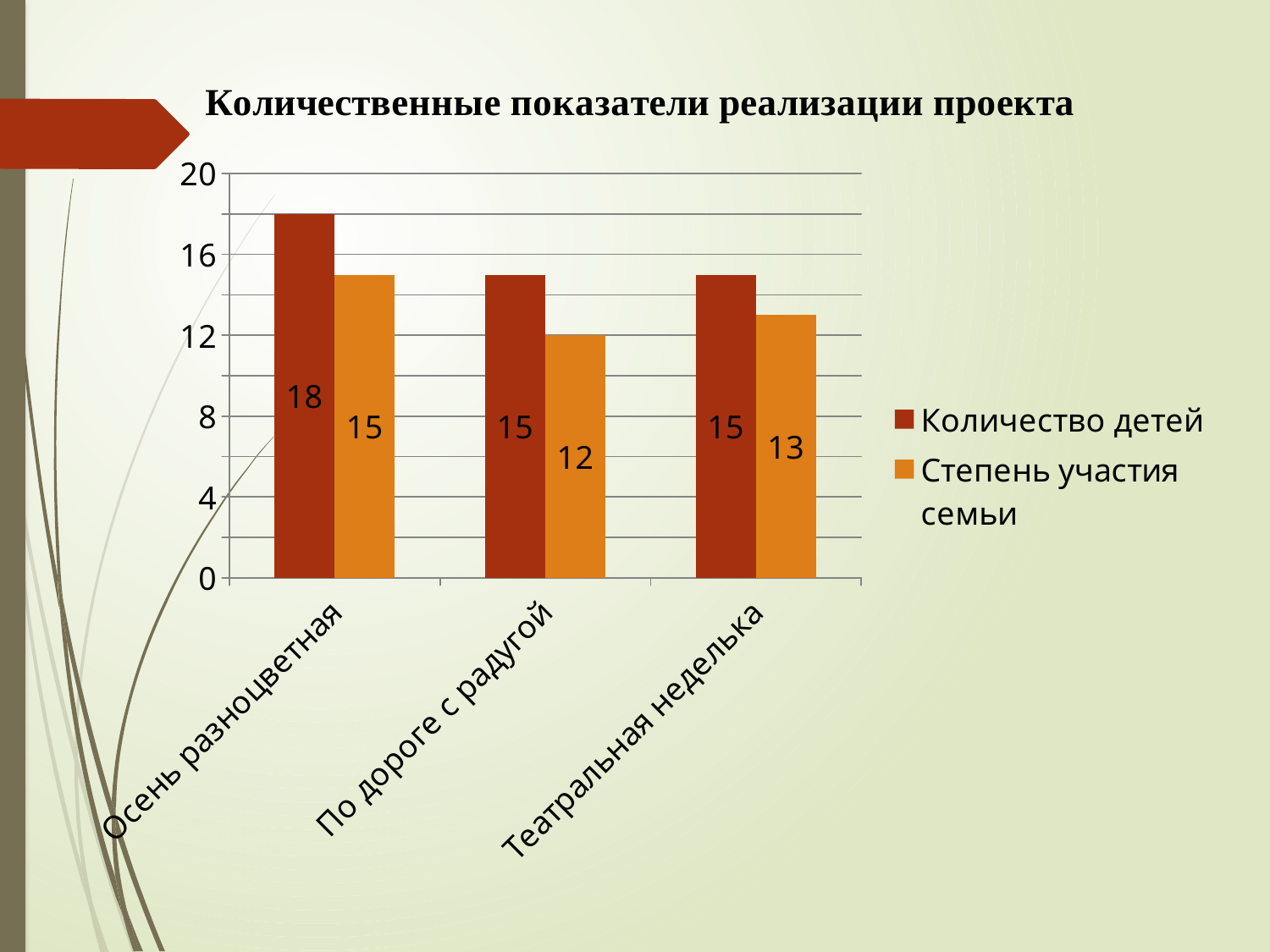
What is the value of Степень участия семьи for Театральная неделька? 13 Which category has the highest value for Количество детей? Осень разноцветная How many series does the legend list? 2 What is the difference between Количество детей and Степень участия семьи for Осень разноцветная? 3 Which is larger for По дороге с радугой: Количество детей or Степень участия семьи? Количество детей What is the value of Количество детей for Осень разноцветная? 18 What is the title of the chart? Количественные показатели реализации проекта Which category has the lowest value for Степень участия семьи? По дороге с радугой What kind of chart is shown on the slide? Bar chart What is the value of Степень участия семьи for По дороге с радугой? 12 How many categories are shown on the x axis? 3 What is the value of Количество детей for Театральная неделька? 15